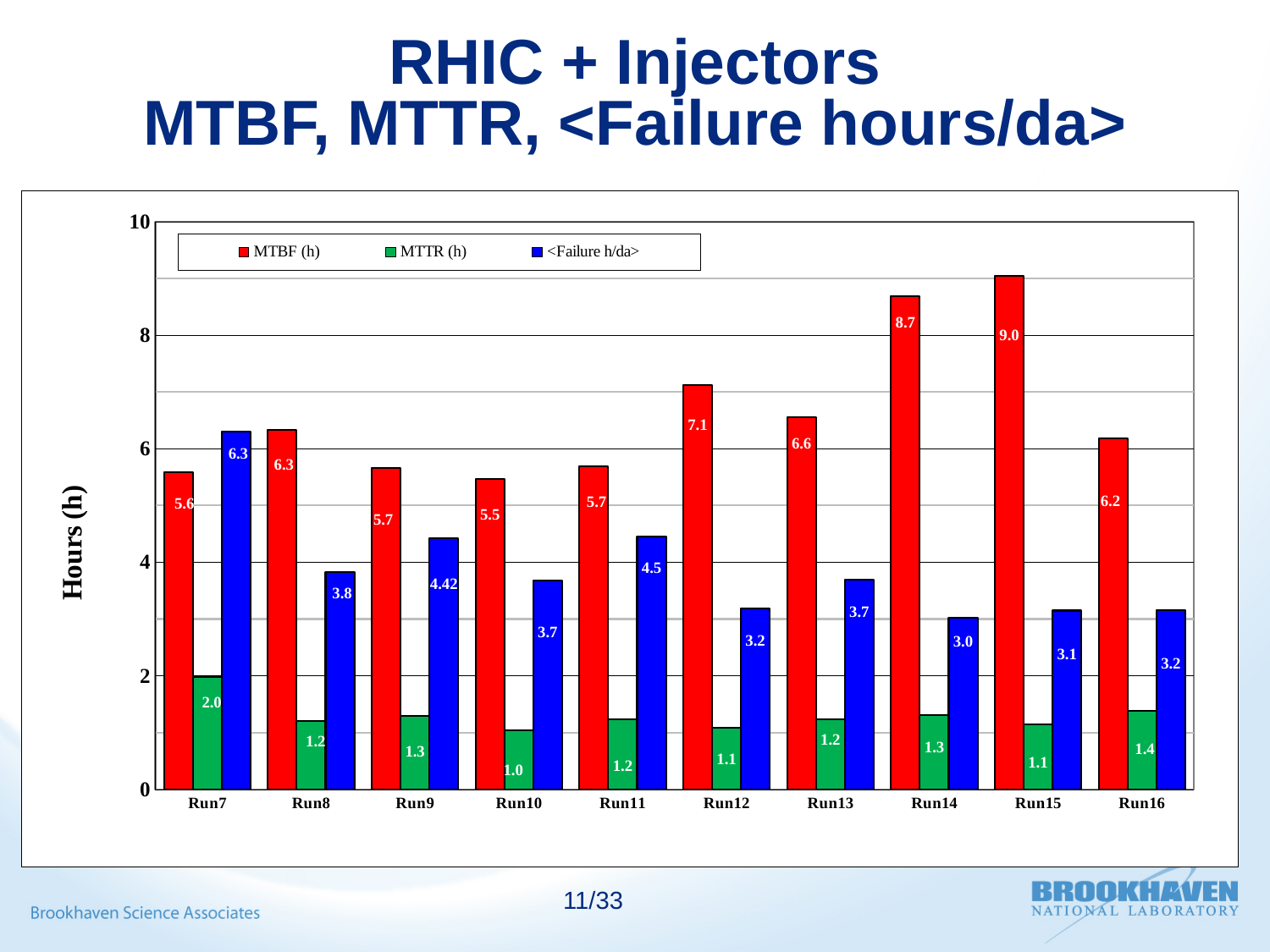
What is the label of the y axis? Hours (h) Which run has the highest <Failure h/da>? Run7 How many series does the legend list? 3 What is the <Failure h/da> value for Run9? 4.42 What is the MTBF (h) value for Run15? 9.0 What is the MTTR (h) value for Run7? 2.0 Which run has the highest MTBF (h)? Run15 What is the difference between the MTBF (h) values for Run14 and Run13? 2.1 What kind of chart is shown on the slide? Bar chart How many runs are shown on the x axis? 10 Which is larger, the <Failure h/da> value for Run8 or for Run11? Run11 Which run has the lowest MTTR (h)? Run10